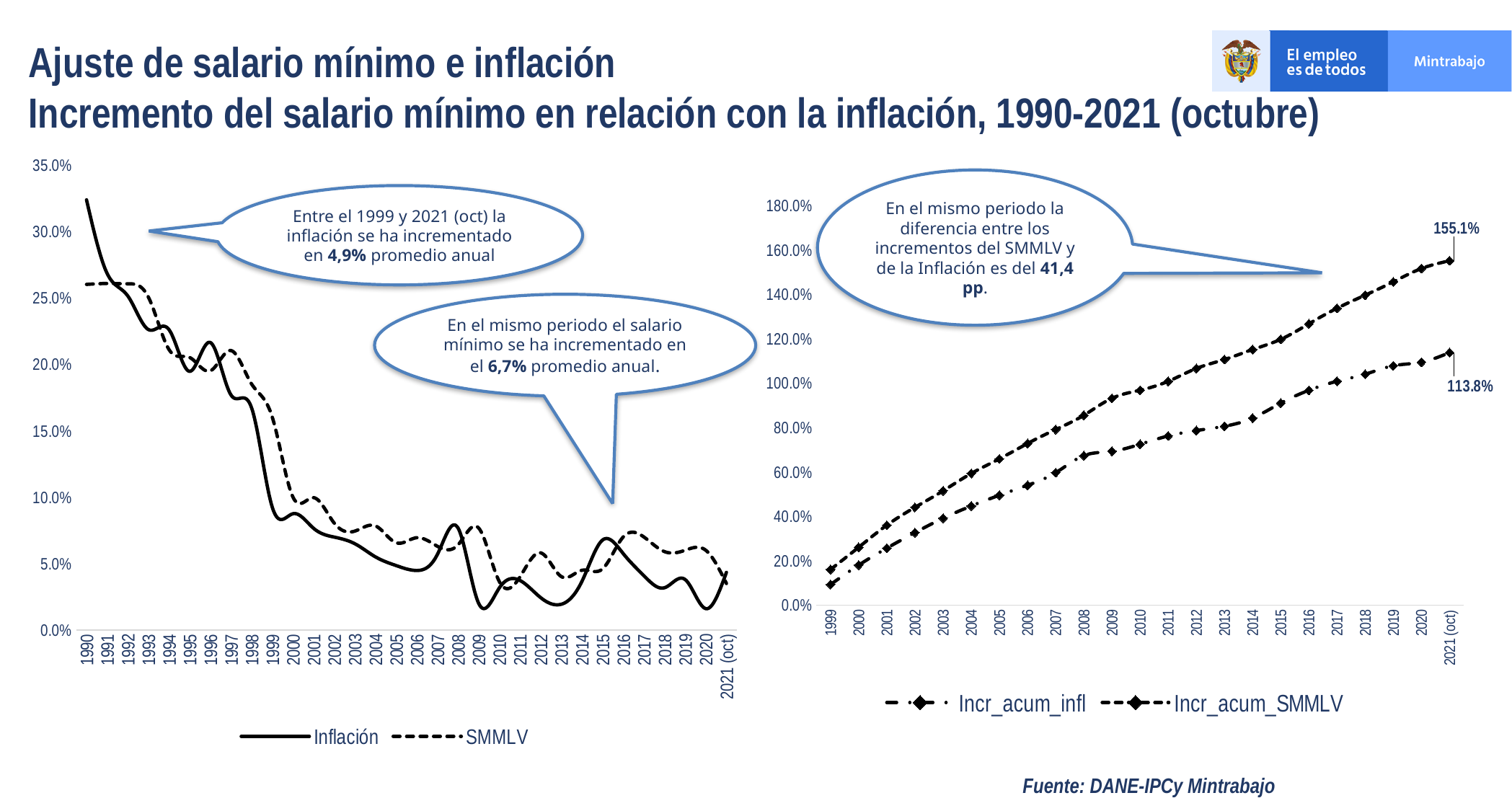
In the right chart, do the values of Incr_acum_SMMLV rise or fall from 1999 to 2021 (oct)? Rise How many series does the legend of the left chart list? 2 What kind of chart is the left chart showing Inflación and SMMLV? Line chart In the right chart, what is the value of Incr_acum_infl in 2021 (oct)? 113.8% In the right chart, what is the value of Incr_acum_SMMLV in 2021 (oct)? 155.1% In the left chart, which series has the higher value in 1990, Inflación or SMMLV? Inflación In the left chart, is the value for Inflación in 1990 greater or less than 30.0%? greater In the left chart, is the value for Inflación in 2009 greater or less than 5.0%? less According to the callout on the left chart, by what average annual rate has inflation increased between 1999 and 2021 (oct)? 4,9% In the right chart, which series is higher in 2021 (oct), Incr_acum_infl or Incr_acum_SMMLV? Incr_acum_SMMLV In the right chart, is the value for Incr_acum_infl in 1999 greater or less than 20.0%? less In the left chart, does the Inflación series overall rise or fall from 1990 to 2021 (oct)? Fall